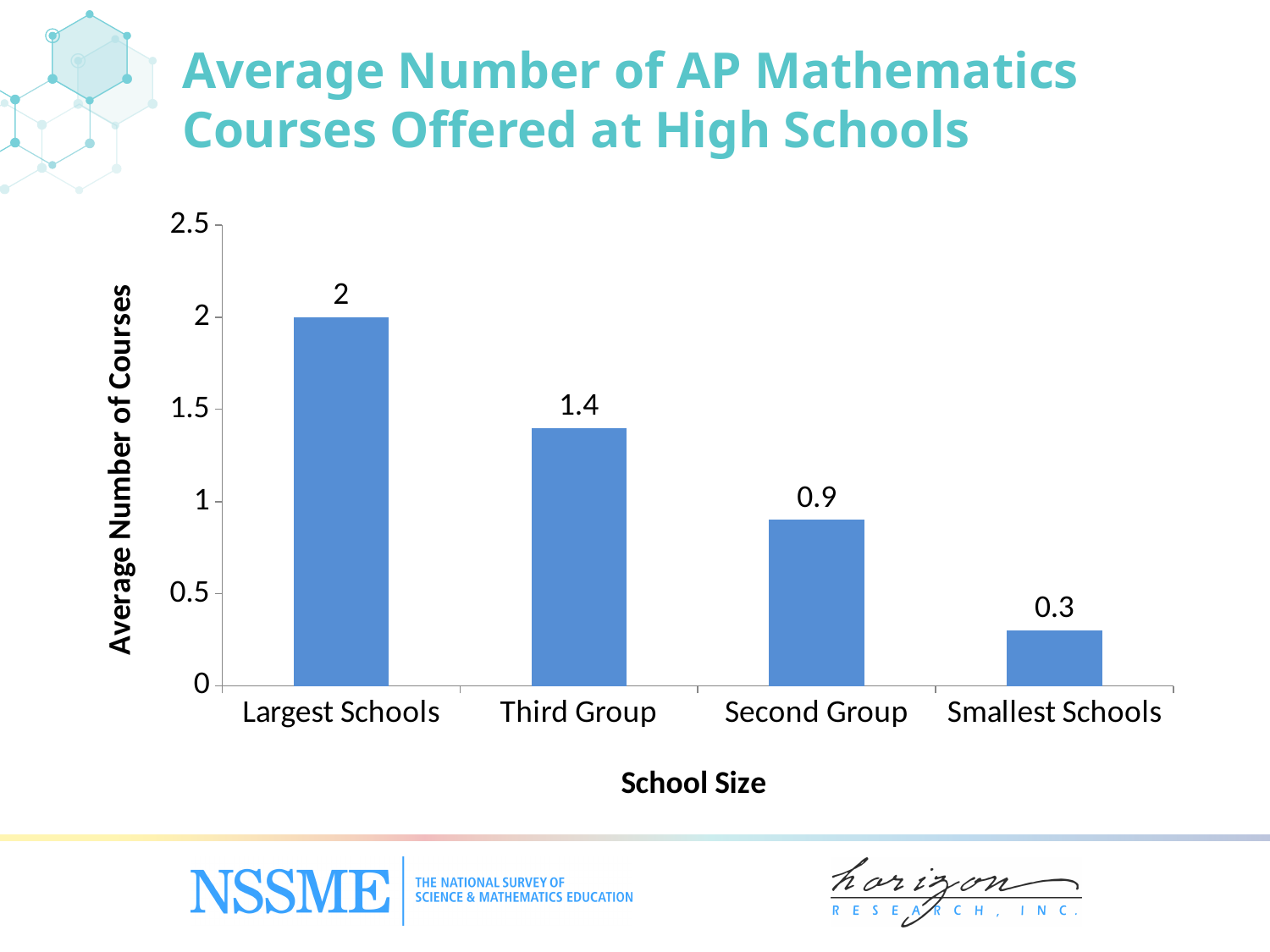
Which school size group has the lowest average number of AP mathematics courses? Smallest Schools What is the average number of AP mathematics courses offered at Third Group schools? 1.4 Which school size group has the highest average number of AP mathematics courses? Largest Schools What is the difference between the average number of courses at the Largest Schools and the Smallest Schools? 1.7 What kind of chart is shown on the slide? Bar chart What is the average number of AP mathematics courses offered at Second Group schools? 0.9 How many school size categories are shown on the chart? 4 What is the average number of AP mathematics courses offered at the Largest Schools? 2 Is the value for Second Group greater or less than 1? less What is the average number of AP mathematics courses offered at the Smallest Schools? 0.3 Do the values rise or fall moving from Largest Schools to Smallest Schools along the x axis? Fall Which has a higher average number of AP mathematics courses, Third Group or Second Group? Third Group